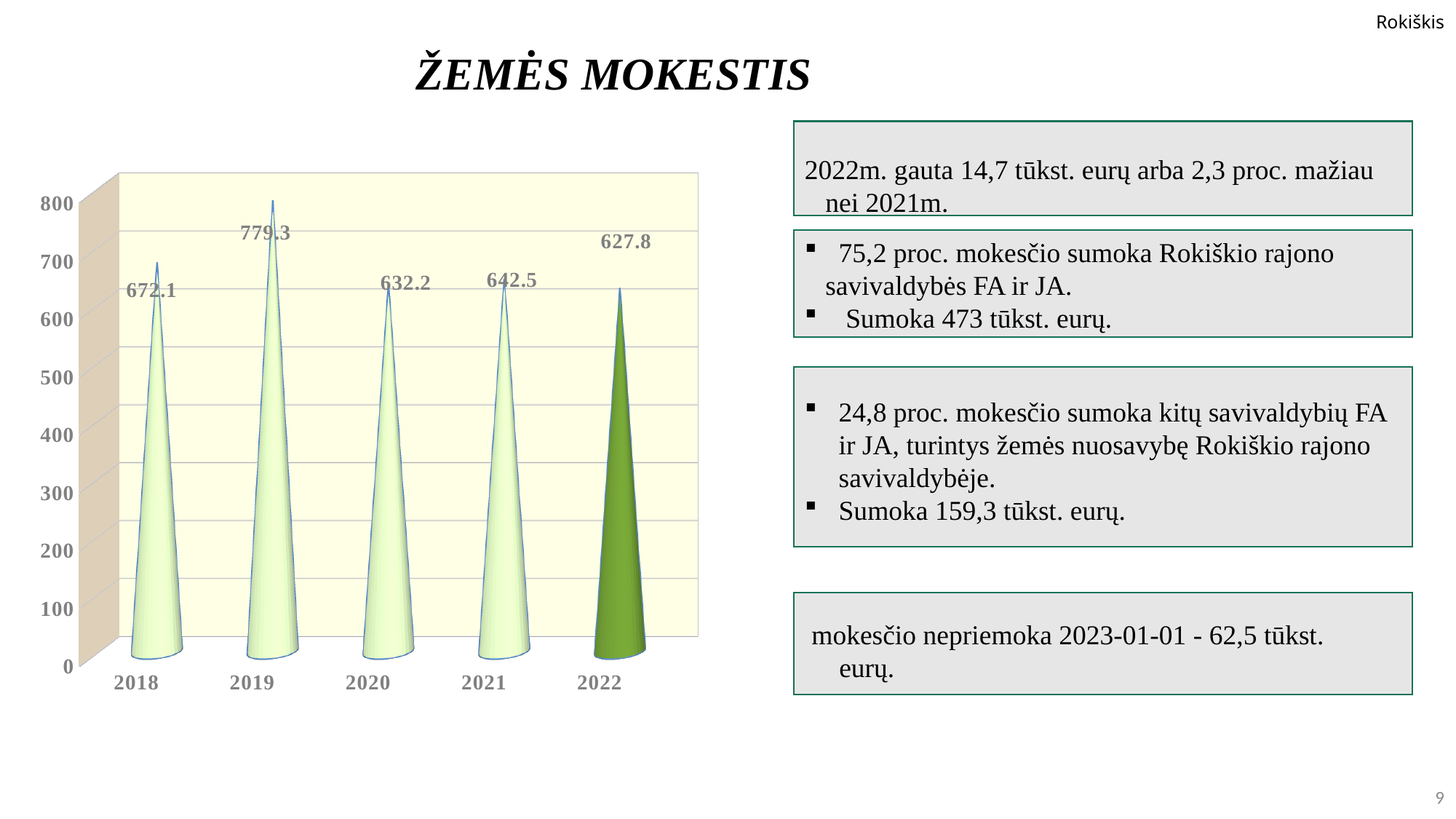
What is the difference between the values for 2019 and 2018? 107.2 What kind of chart is shown on the slide? bar chart Is the value for 2019 greater or less than 700? greater Which year has the highest value? 2019 Does the value rise or fall from 2019 to 2020? fall What is the value for 2022? 627.8 What is the value for 2018? 672.1 What is the value for 2019? 779.3 What is the difference between the values for 2021 and 2022? 14.7 Which is larger, the value for 2020 or the value for 2021? 2021 Which year has the lowest value? 2022 How many years are shown on the x axis? 5